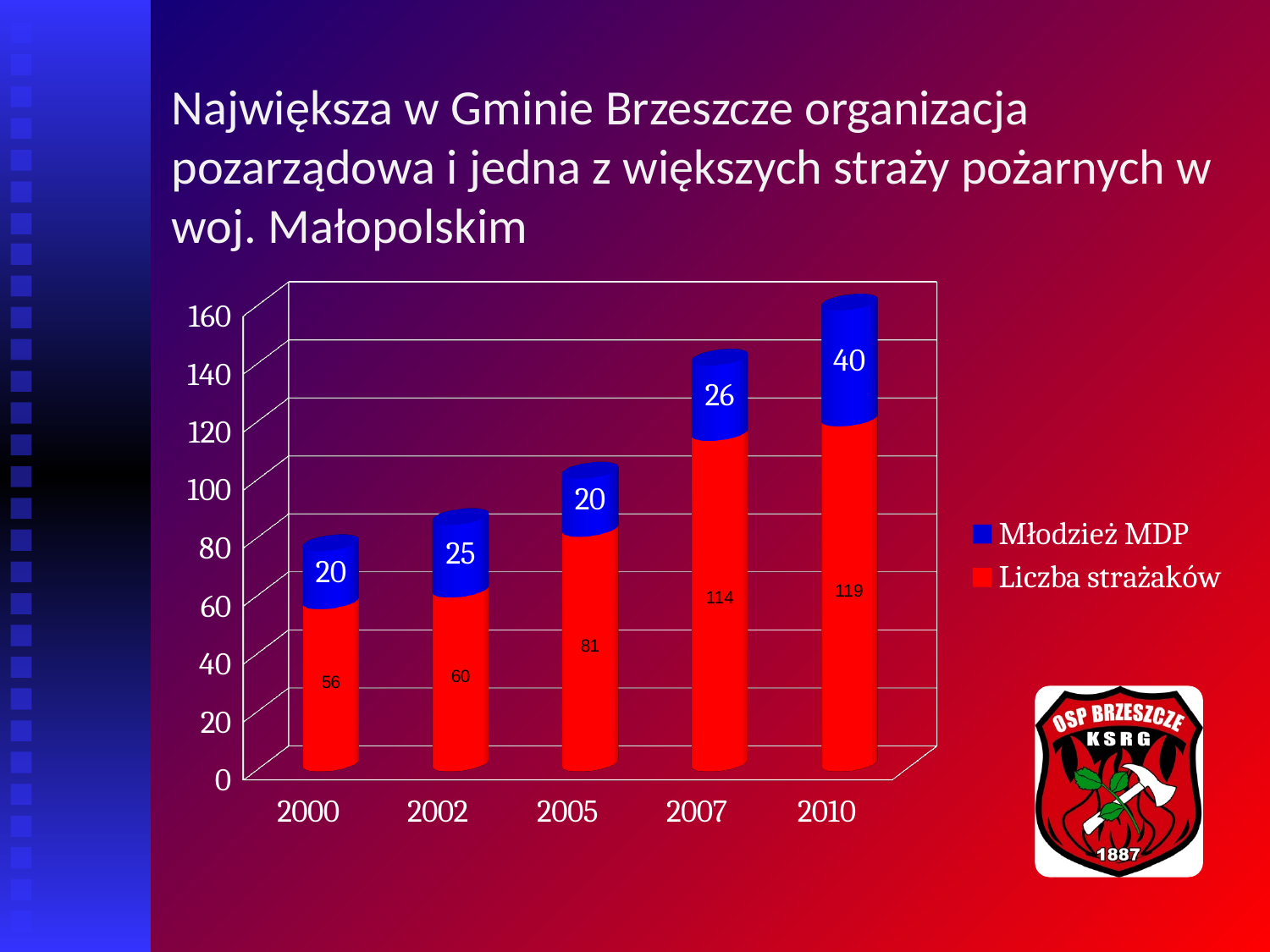
What is the total of the stacked bar for 2010? 159 What is the value of Liczba strażaków for 2000? 56 Which is larger: Młodzież MDP in 2002 or Młodzież MDP in 2007? 2007 What kind of chart is shown on the slide? Stacked bar chart Which year has the highest value for Liczba strażaków? 2010 How many years are shown on the x axis? 5 Which year has the lowest value for Młodzież MDP? 2000 and 2005 Does the value of Liczba strażaków rise or fall from 2000 to 2010? Rise How many series does the legend list? 2 What is the difference between Liczba strażaków in 2010 and in 2000? 63 What is the value of Liczba strażaków for 2007? 114 What is the value of Młodzież MDP for 2010? 40